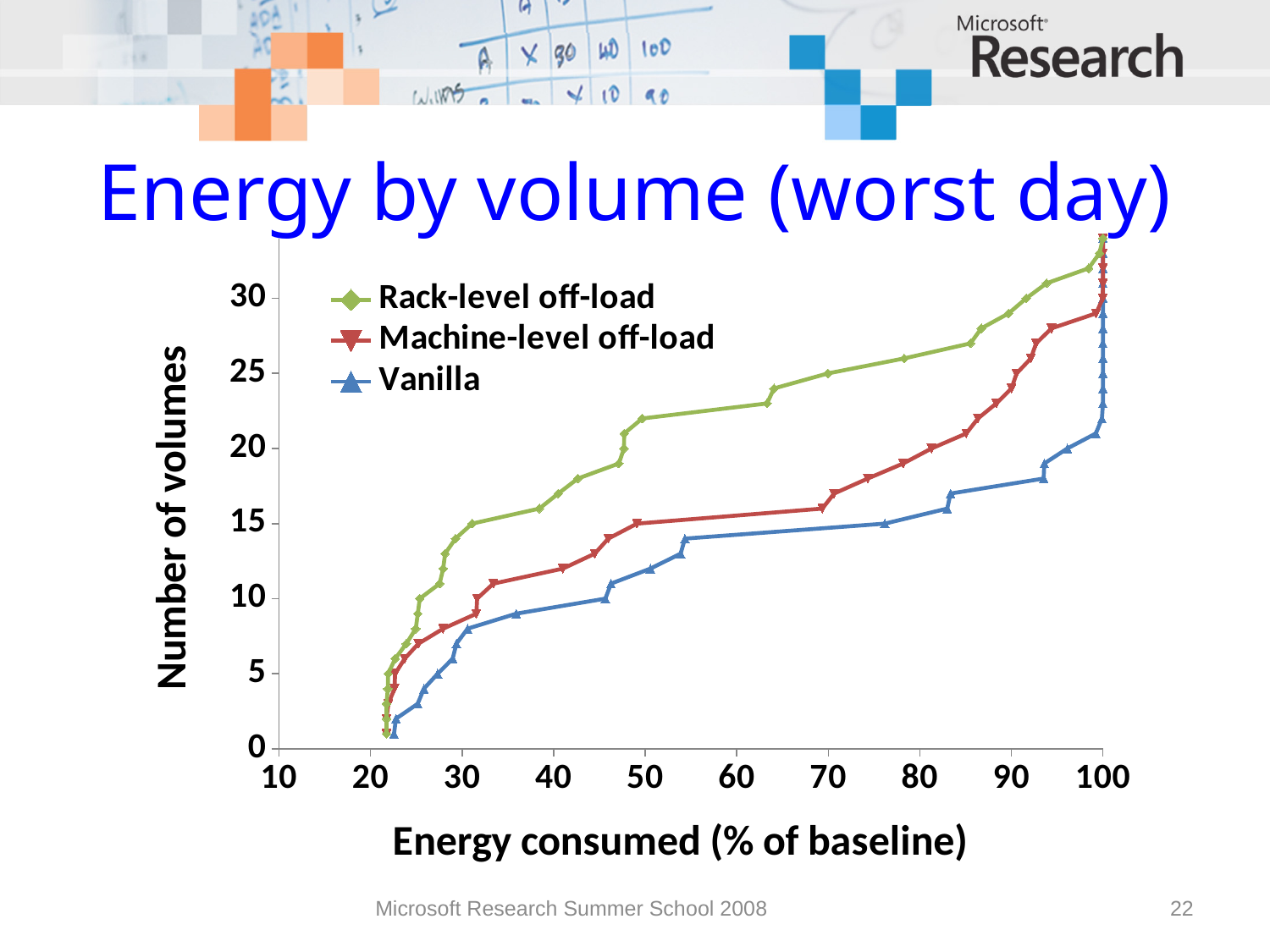
How many series does the legend list? 3 Does the number of volumes rise or fall as energy consumed increases along the x axis? rise Is the energy consumed by the Vanilla series at 20 volumes greater or less than 90? greater What kind of chart is shown on the slide? line chart What is the title of the chart? Energy by volume (worst day) What is the label of the x axis? Energy consumed (% of baseline) Is the energy consumed by the Rack-level off-load series at 15 volumes greater or less than 40? less Which series is drawn in green? Rack-level off-load At 20 volumes, which series consumes more energy: Machine-level off-load or Vanilla? Vanilla Is the energy consumed by the Vanilla series at 15 volumes greater or less than 70? greater At 20 volumes, which series consumes the least energy: Rack-level off-load, Machine-level off-load or Vanilla? Rack-level off-load